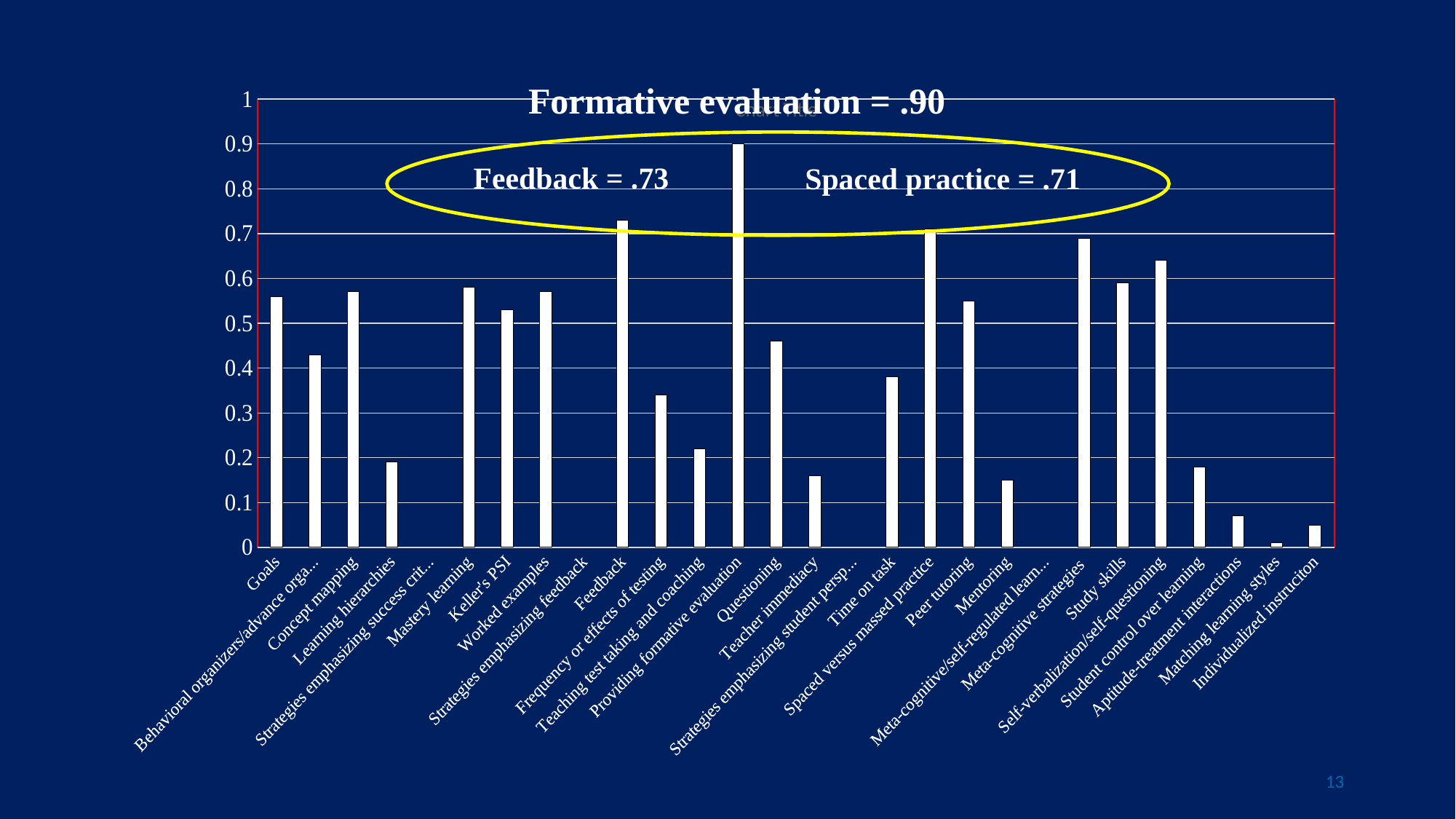
Is the value for Mentoring greater or less than 0.2? less What is the value for Feedback? .73 Which category has the lowest bar? Matching learning styles Which category has the highest bar? Providing formative evaluation Is the value for Meta-cognitive strategies greater or less than 0.6? greater What is the value for Spaced versus massed practice? .71 What colour are the bars in the chart? white Is the value for Goals greater or less than 0.5? greater What is the difference between the values for Providing formative evaluation and Feedback? .17 What kind of chart is shown on the slide? bar chart Which is larger, the value for Study skills or the value for Questioning? Study skills What is the value for Providing formative evaluation? .90